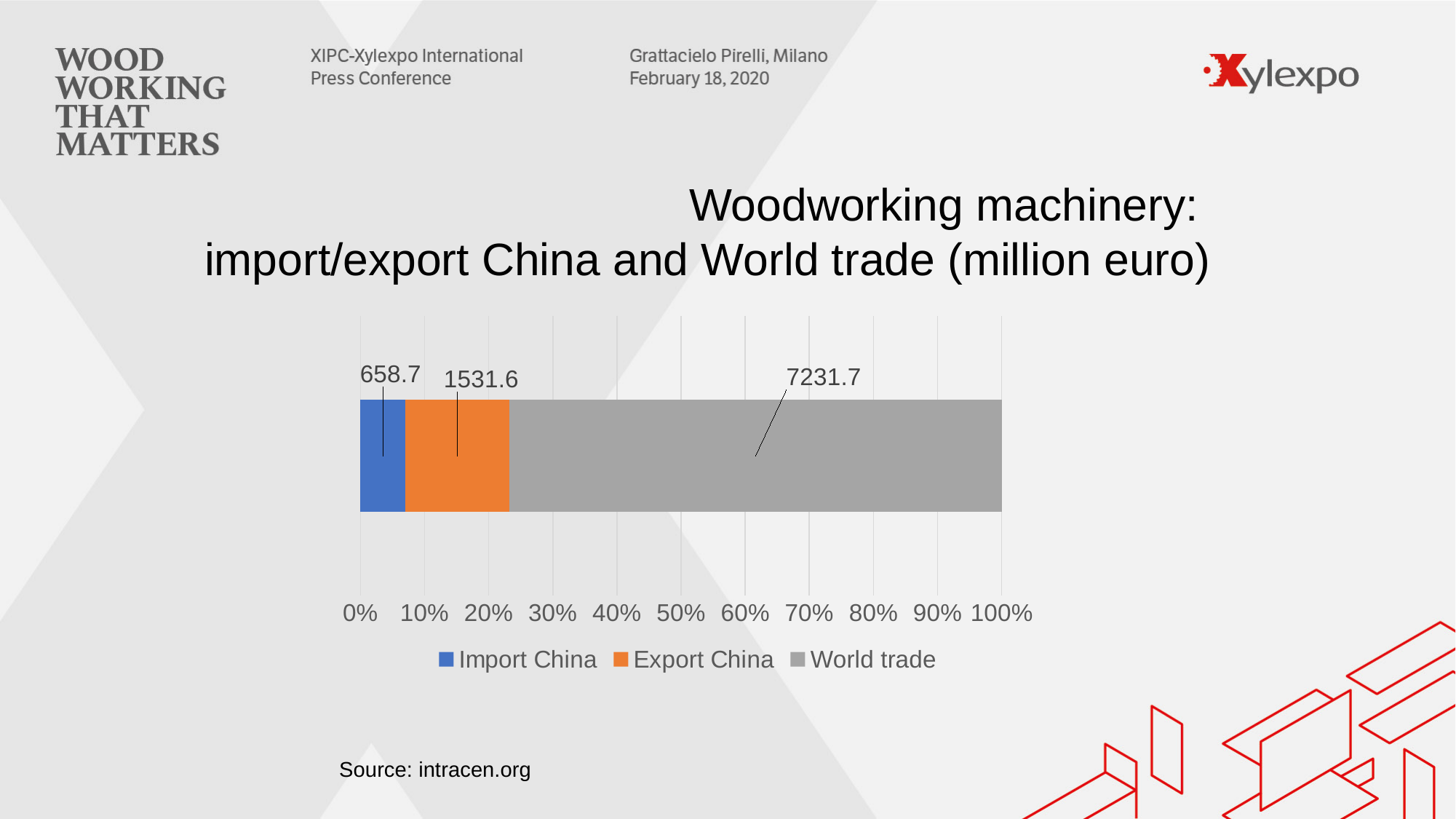
What is the difference between the Export China and Import China values? 872.9 Which is larger, Export China or Import China? Export China What is the value for World trade? 7231.7 What is the value for Import China? 658.7 What is the total of the stacked bar? 9422.0 What colour represents World trade in the chart? Grey Which series has the highest value? World trade What is the value for Export China? 1531.6 Which series has the lowest value? Import China How many series does the legend list? 3 What kind of chart is shown on the slide? Stacked bar chart What is the difference between the World trade and Export China values? 5700.1